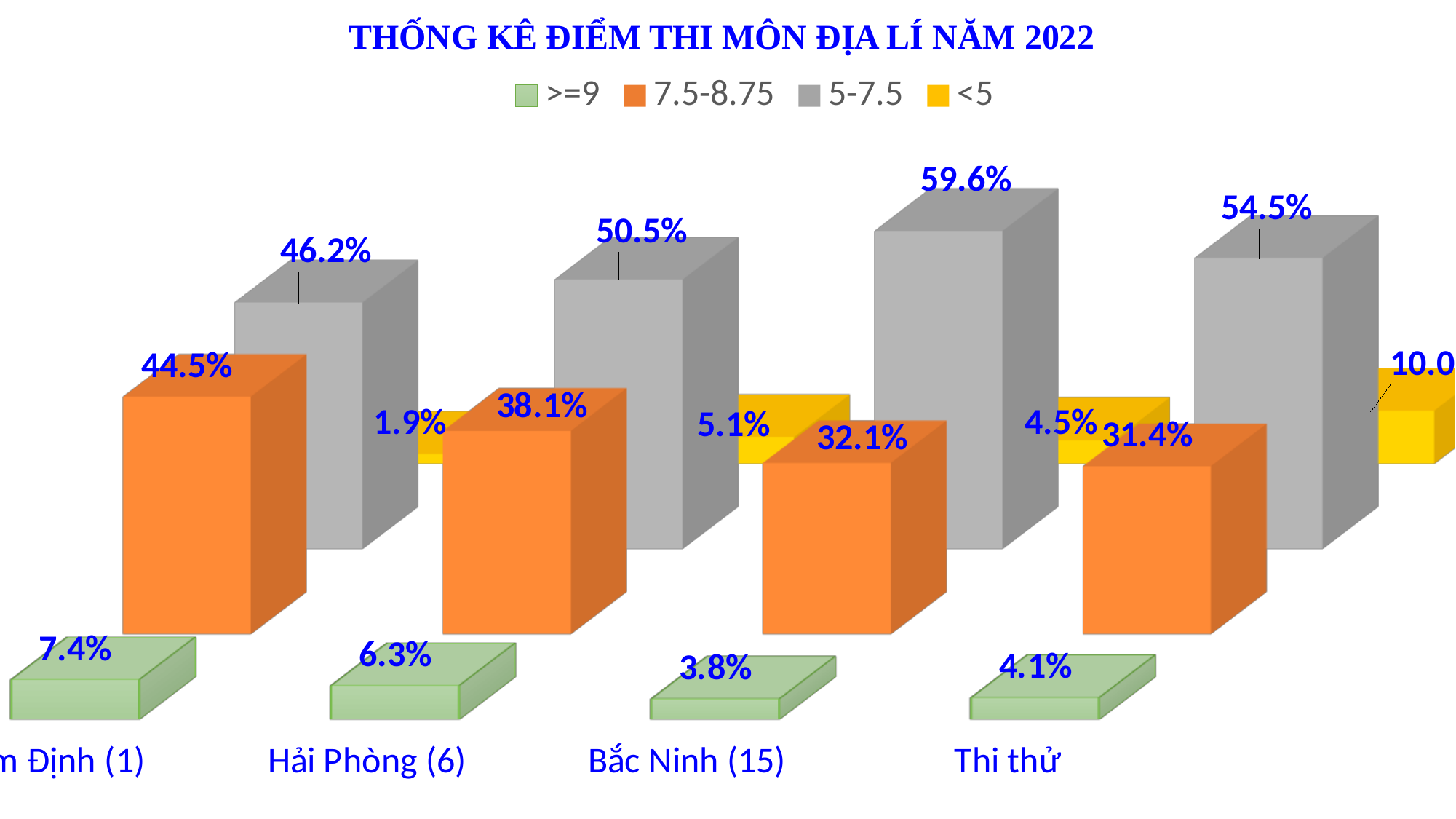
How many series does the legend list? 4 Which category has the highest value in the 5-7.5 series? Bắc Ninh (15) For Hải Phòng (6), how much larger is the 5-7.5 value than the 7.5-8.75 value? 12.4 percentage points What is the value for Hải Phòng (6) in the 5-7.5 series? 50.5% How many categories are shown on the x axis? 4 Which category has the lowest value in the >=9 series? Bắc Ninh (15) What kind of chart is shown on the slide? Bar chart What is the value for Bắc Ninh (15) in the >=9 series? 3.8% Do the values in the 7.5-8.75 series rise or fall from left to right across the categories? Fall What is the value for Hải Phòng (6) in the <5 series? 5.1% What is the value for Thi thử in the 7.5-8.75 series? 31.4% In the <5 series, which is larger: Hải Phòng (6) or Bắc Ninh (15)? Hải Phòng (6)